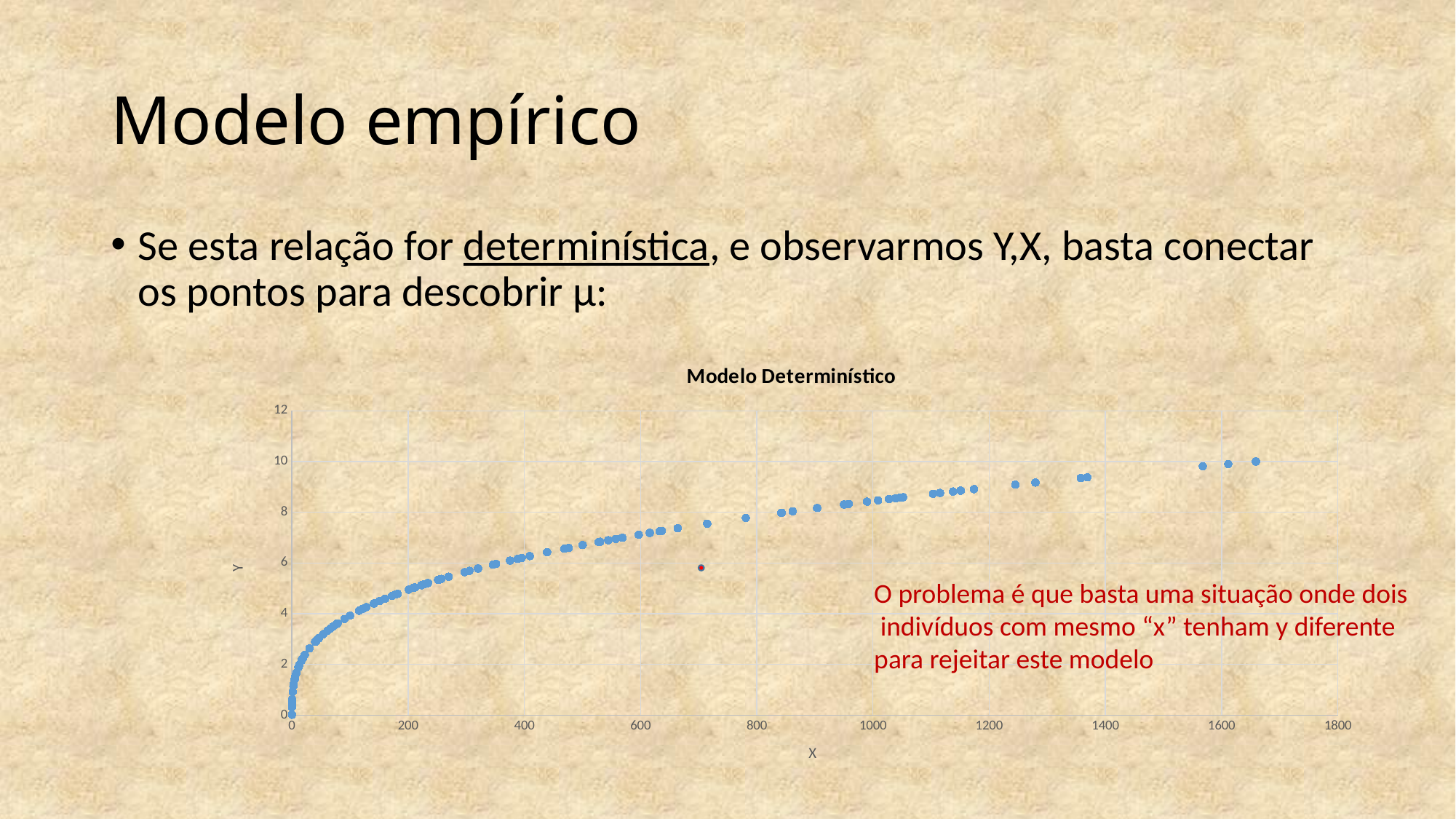
Is the Y value of the point near X = 400 greater or less than 4? greater Do the Y values rise or fall as X increases along the horizontal axis? Rise What is the title of the chart? Modelo Determinístico Is the Y value of the point near X = 200 greater or less than 6? less Is the Y value of the point near X = 1600 greater or less than 8? greater What is the highest tick value shown on the vertical axis? 12 What is the label of the horizontal axis of the chart? X What kind of chart is shown on the slide? Scatter chart Which point has a higher Y value: the one near X = 1600 or the one near X = 200? The one near X = 1600 What is the highest tick value shown on the horizontal axis? 1800